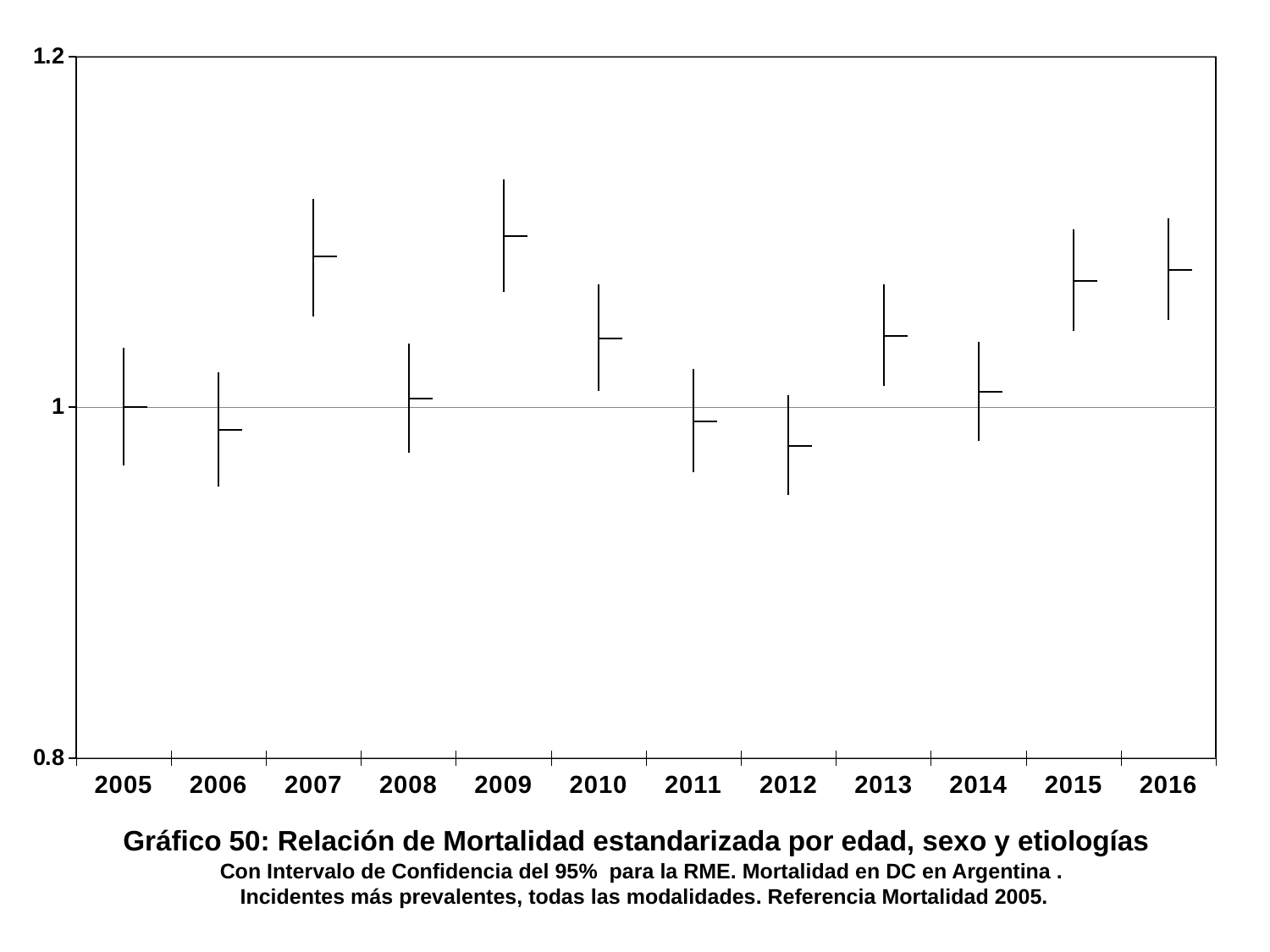
What is the value for 2005, the reference year? 1 Which is larger, the value for 2015 or the value for 2014? 2015 What is the highest value labelled on the y axis? 1.2 Is the value for 2007 greater or less than 1? greater Which year has the highest value? 2009 Is the value for 2009 greater or less than 1? greater How many years are shown on the x axis of the chart? 12 What is the first year shown on the x axis? 2005 Is the value for 2012 greater or less than 1? less Which is larger, the value for 2009 or the value for 2012? 2009